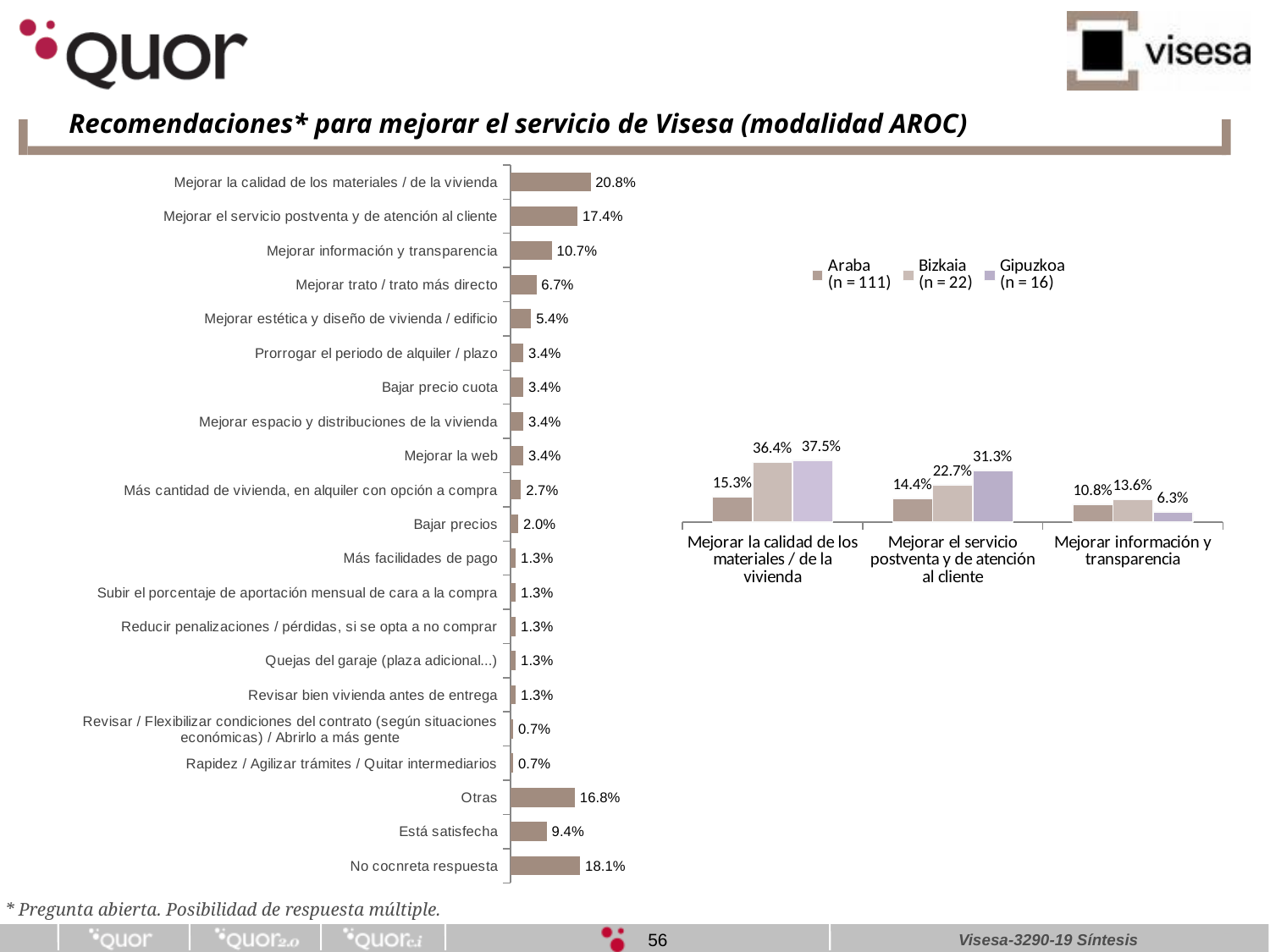
In the left chart, which is larger: "Otras" or "Está satisfecha"? Otras In the left chart, what is the difference between "Mejorar el servicio postventa y de atención al cliente" and "Mejorar información y transparencia"? 6.7% In the left chart, what is the value for "Mejorar la calidad de los materiales / de la vivienda"? 20.8% In the right chart, what is the difference between Gipuzkoa and Araba for "Mejorar el servicio postventa y de atención al cliente"? 16.9% In the right chart, which series has the highest value for "Mejorar la calidad de los materiales / de la vivienda"? Gipuzkoa In the right chart, what is the value for Bizkaia in "Mejorar la calidad de los materiales / de la vivienda"? 36.4% How many series does the legend of the right chart list? 3 What type of chart is the left chart? Bar chart How many categories are shown in the left chart? 21 In the left chart, which category has the highest value? Mejorar la calidad de los materiales / de la vivienda In the right chart, what is the value for Gipuzkoa in "Mejorar información y transparencia"? 6.3% In the left chart, what is the value for "Mejorar trato / trato más directo"? 6.7%